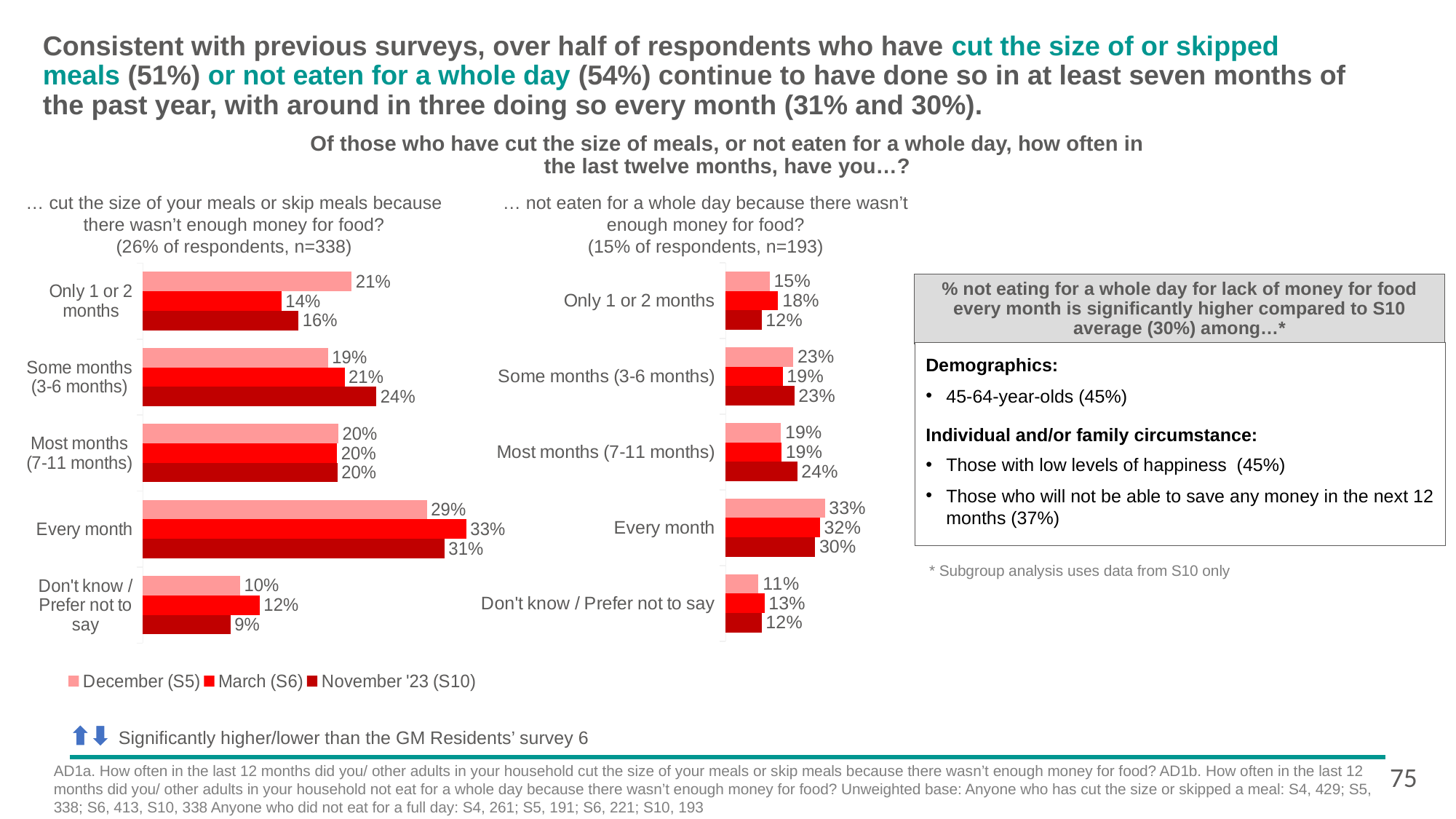
In the right chart (not eaten for a whole day), what is the March (S6) value for Only 1 or 2 months? 18% In the right chart (not eaten for a whole day), which is larger for Some months (3-6 months): the December (S5) value or the March (S6) value? December (S5) What is the sample size (n) shown in the subtitle of the right chart (not eaten for a whole day)? n=193 How many categories are shown in the left chart (cut the size of your meals or skip meals)? 5 In the left chart (cut the size of your meals or skip meals), what is the November '23 (S10) value for Every month? 31% In the left chart (cut the size of your meals or skip meals), what is the difference between the March (S6) and December (S5) values for Every month? 4% In the right chart (not eaten for a whole day), what is the difference between the November '23 (S10) and March (S6) values for Most months (7-11 months)? 5% In the right chart (not eaten for a whole day), which category has the highest November '23 (S10) value? Every month In the left chart (cut the size of your meals or skip meals), which category has the lowest November '23 (S10) value? Don't know / Prefer not to say What type of chart is used for the right chart (not eaten for a whole day)? Bar chart In the left chart (cut the size of your meals or skip meals), what is the December (S5) value for Don't know / Prefer not to say? 10% How many series does the legend list? 3